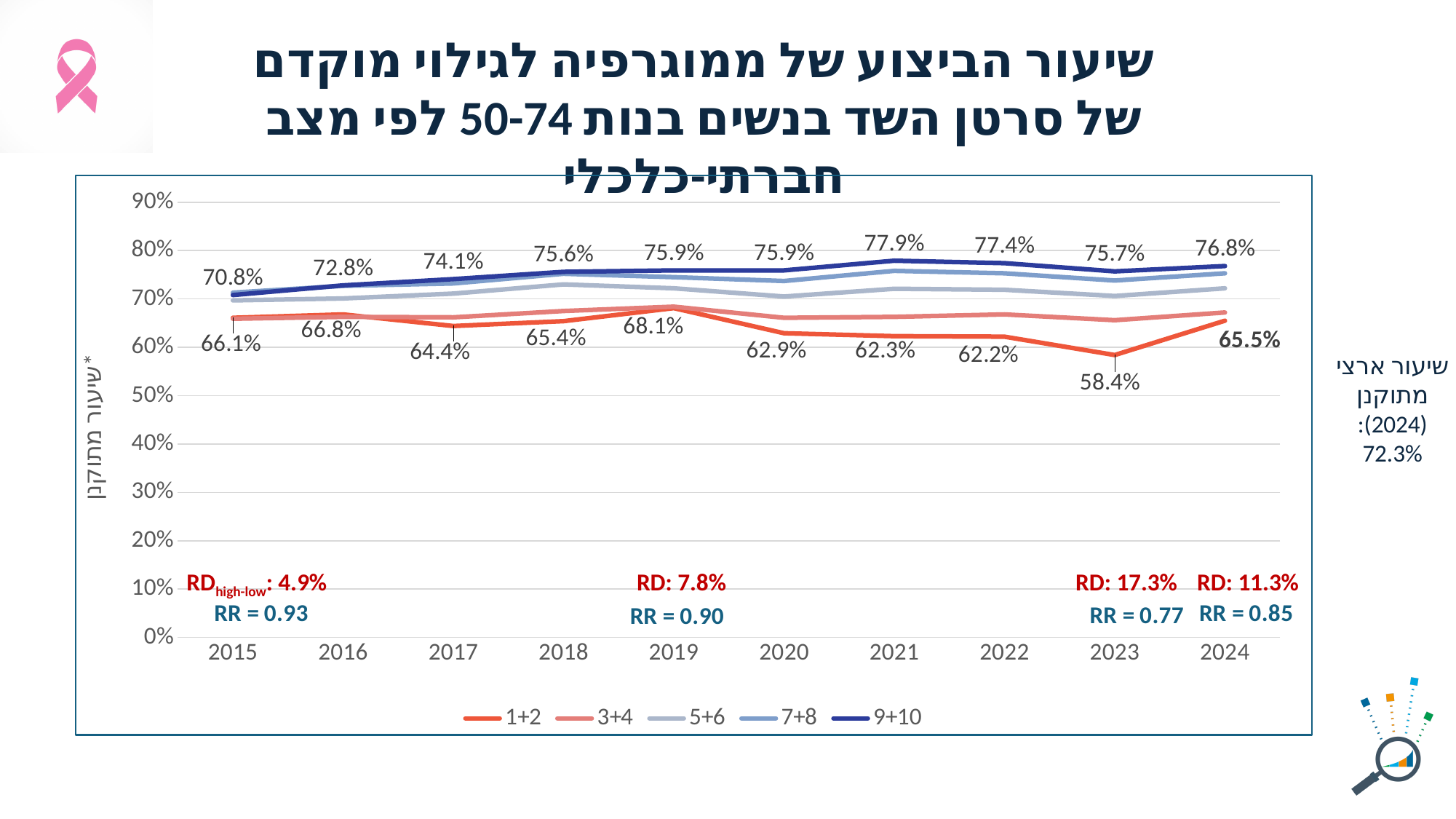
Which series has the larger value in 2015, 9+10 or 1+2? 9+10 What is the value for the 1+2 series in 2023? 58.4% What is the value for the 9+10 series in 2021? 77.9% How many years are shown on the x axis? 10 What is the difference between the 9+10 series and the 1+2 series in 2023? 17.3% In which year does the 9+10 series reach its highest value? 2021 Does the 9+10 series rise or fall from 2015 to 2018? rise What type of chart is shown on the slide? line chart Is the value for the 1+2 series in 2023 greater or less than 60%? less How many series does the legend list? 5 In which year does the 1+2 series reach its lowest value? 2023 What is the value for the 1+2 series in 2024? 65.5%